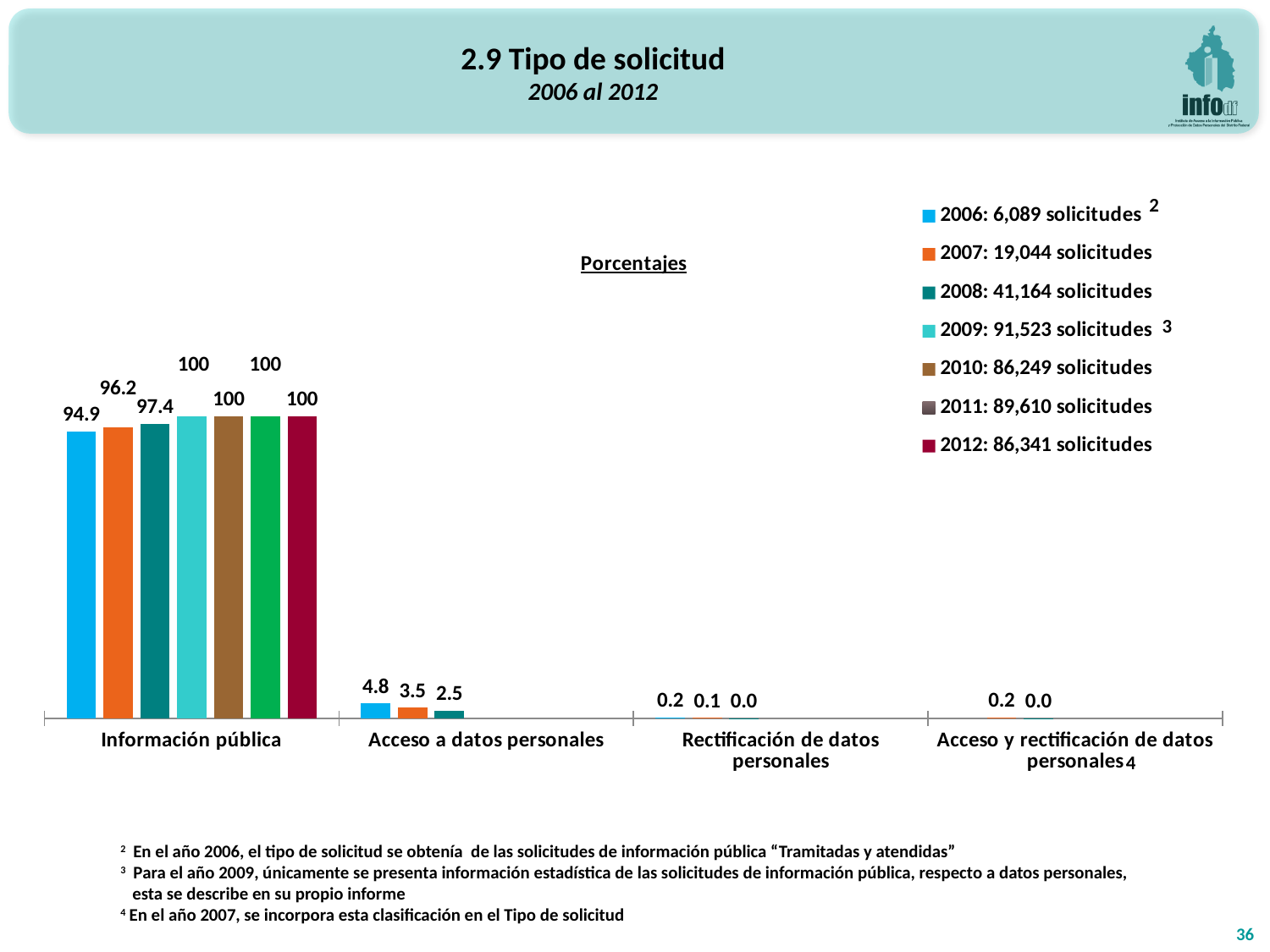
How many categories are shown on the x axis? 4 What is the difference between the 2007 and 2006 values in the Información pública category? 1.3 What is the difference between the 2006 and 2007 values in the Acceso a datos personales category? 1.3 How many series does the legend list? 7 What is the value for 2006 in the Información pública category? 94.9 What kind of chart is shown on the slide? Bar chart What is the value for 2008 in the Acceso a datos personales category? 2.5 What is the value for 2008 in the Información pública category? 97.4 What is the value for 2006 in the Acceso a datos personales category? 4.8 What is the value for 2007 in the Rectificación de datos personales category? 0.1 Which year has the lowest value in the Información pública category? 2006 Which is larger in the Acceso a datos personales category, the 2006 value or the 2008 value? 2006